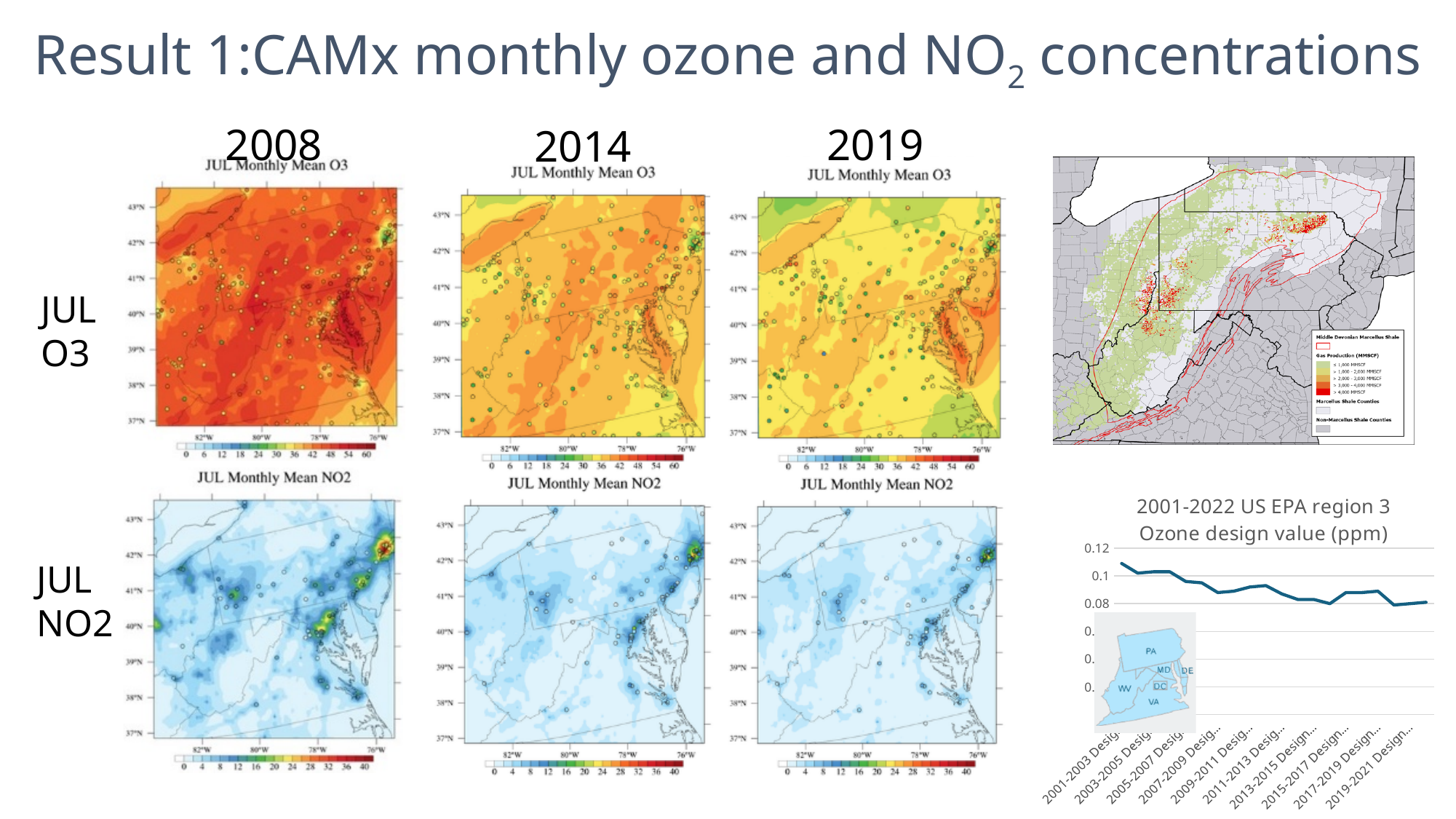
In the '2001-2022 US EPA region 3 Ozone design value (ppm)' chart, is the value for the 2001-2003 design period greater or less than 0.1? greater What is the highest tick value shown on the y axis of the '2001-2022 US EPA region 3 Ozone design value (ppm)' chart? 0.12 What kind of chart is the '2001-2022 US EPA region 3 Ozone design value (ppm)' chart? line chart In the '2001-2022 US EPA region 3 Ozone design value (ppm)' chart, is the value for the 2019-2021 design period greater or less than 0.1? less In the '2001-2022 US EPA region 3 Ozone design value (ppm)' chart, which is larger: the value for 2001-2003 or the value for 2019-2021? 2001-2003 What unit is given in the title of the line chart on the right of the slide? ppm In the '2001-2022 US EPA region 3 Ozone design value (ppm)' chart, which design period has the highest value? 2001-2003 In the '2001-2022 US EPA region 3 Ozone design value (ppm)' chart, do the values generally rise or fall from left to right along the x axis? fall In the '2001-2022 US EPA region 3 Ozone design value (ppm)' chart, is the value for the 2011-2013 design period greater or less than 0.12? less